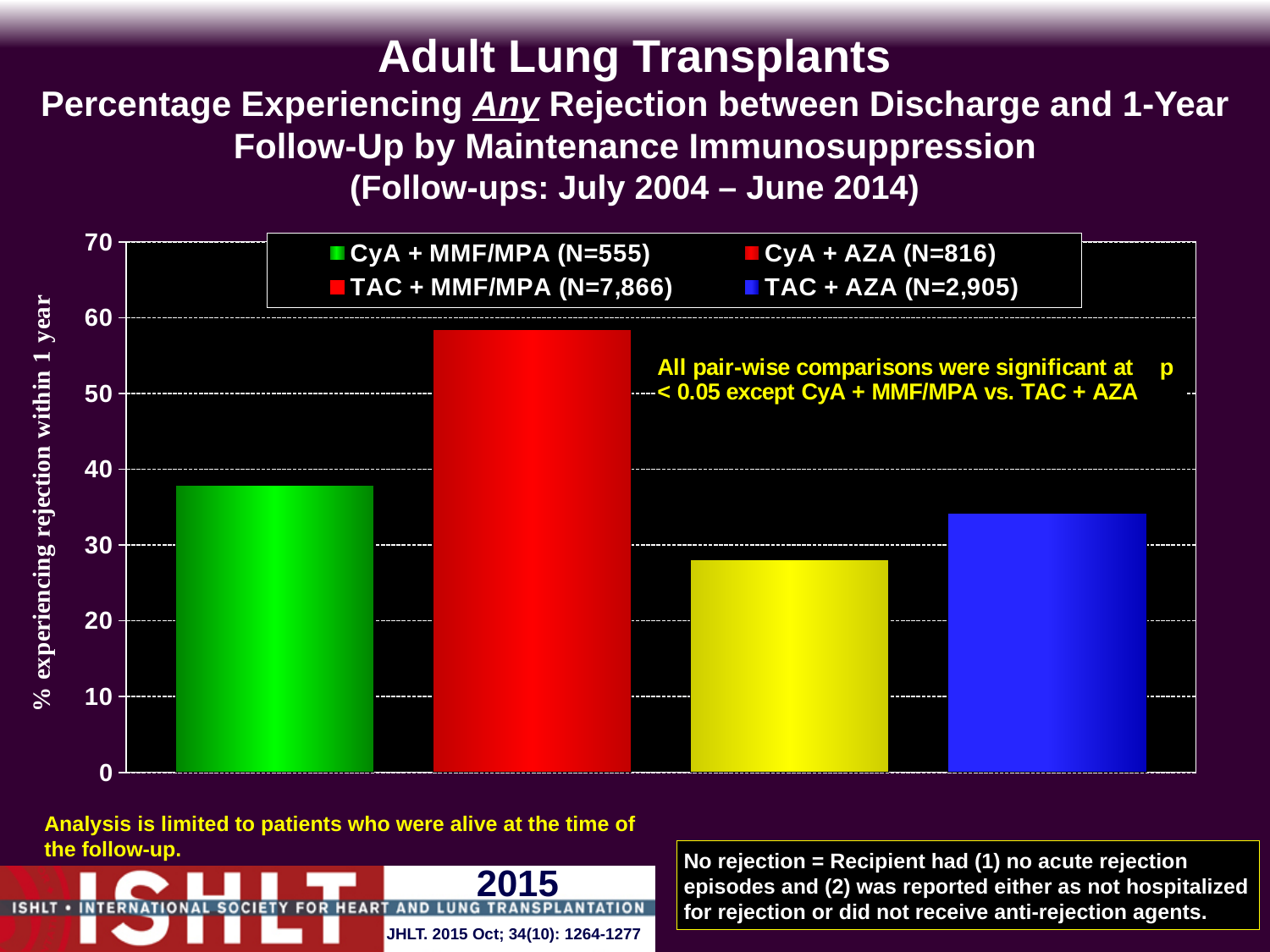
What kind of chart is shown on the slide? bar chart Is the value for CyA + AZA greater or less than 50? greater Is the value for TAC + AZA greater or less than 30? greater Is the value for CyA + MMF/MPA greater or less than 40? less What is the sample size (N) shown in the legend for TAC + MMF/MPA? 7,866 Which is larger, the value for CyA + AZA or the value for TAC + AZA? CyA + AZA How many bars are plotted in the chart? 4 How many entries does the chart legend list? 4 Which maintenance immunosuppression group has the lowest percentage experiencing rejection within 1 year? TAC + MMF/MPA Which maintenance immunosuppression group has the highest percentage experiencing rejection within 1 year? CyA + AZA